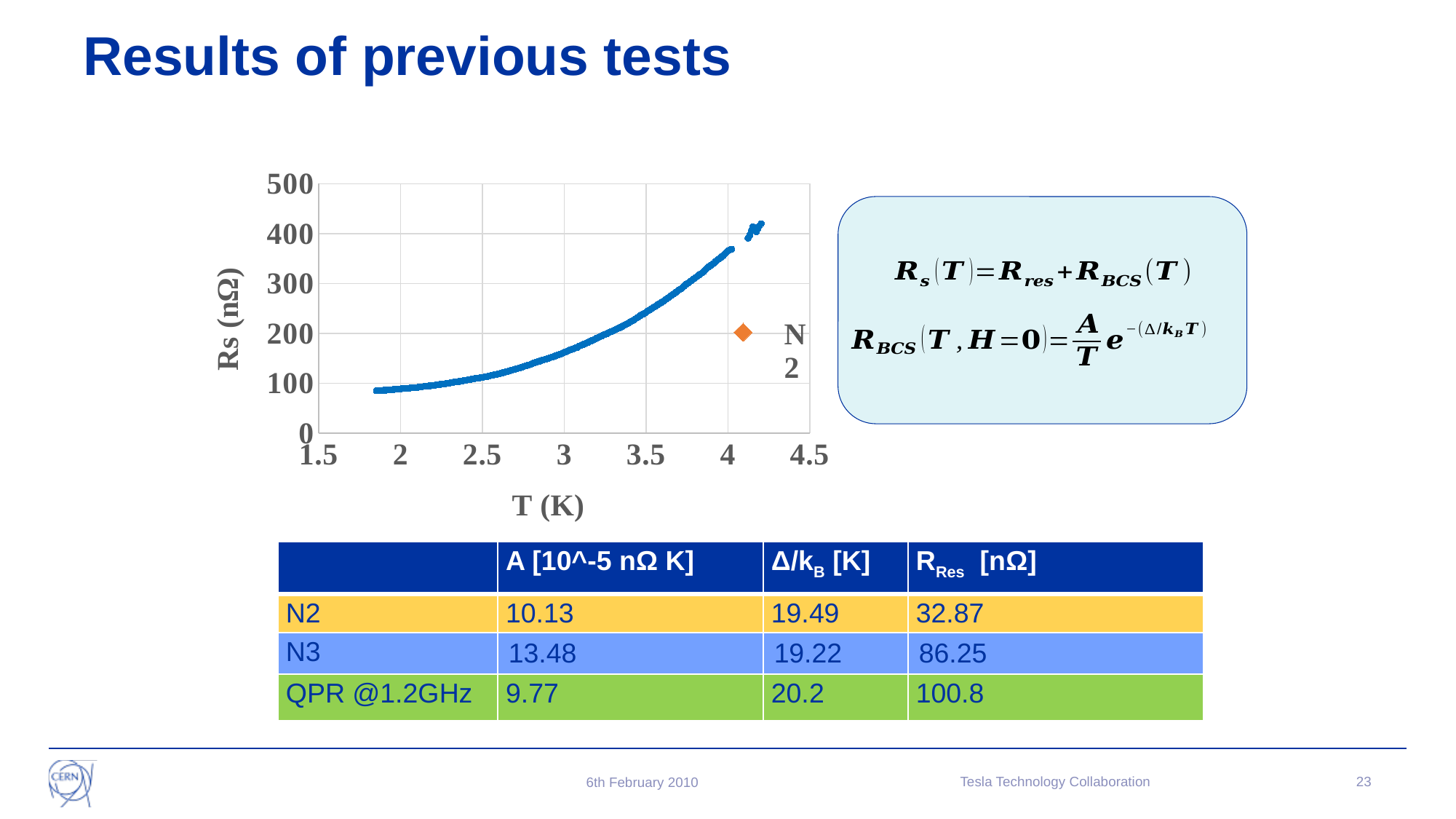
Is the highest plotted Rs value in the chart greater or less than 400? greater Is the plotted Rs value at T = 3.5 K greater or less than 200? greater Is the plotted Rs value at T = 3 K greater or less than 200? less How many series does the chart's legend list? 1 What is the label of the x axis of the chart? T (K) What is the highest tick value shown on the y axis of the chart? 500 What kind of chart is shown on the slide? Scatter chart Do the plotted Rs values rise or fall as T increases along the x axis? Rise What is the label of the y axis of the chart? Rs (nΩ)